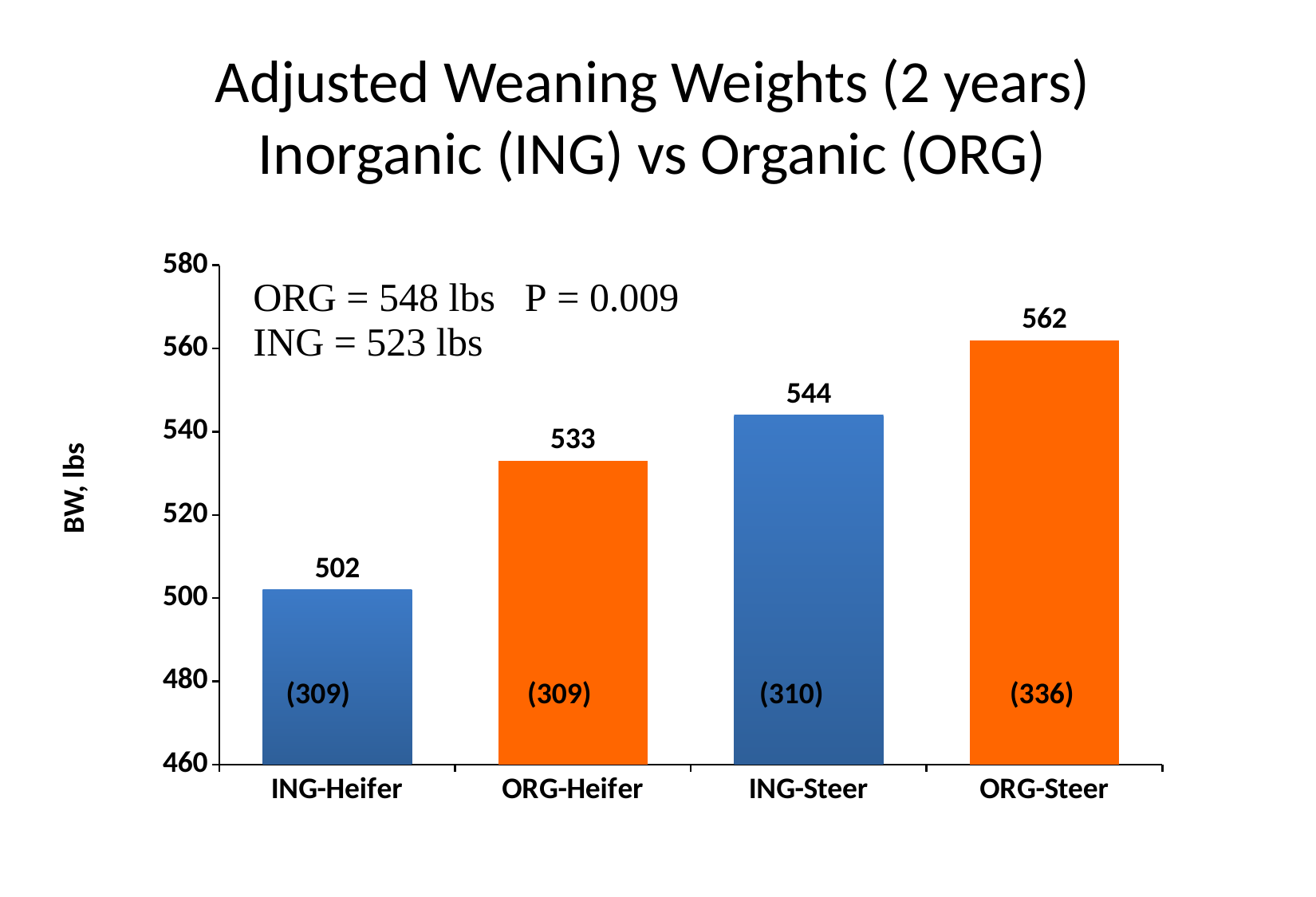
What is the value shown for ORG-Heifer? 533 What is the adjusted weaning weight for ORG-Steer? 562 Which category has the highest adjusted weaning weight? ORG-Steer What is the difference between the ORG-Heifer and ING-Heifer values? 31 What is the adjusted weaning weight for ING-Heifer? 502 Which category has the lowest adjusted weaning weight? ING-Heifer What kind of chart is shown on the slide? Bar chart Which is larger, the value for ING-Steer or ORG-Heifer? ING-Steer Is the value for ING-Steer greater or less than 540? greater What is the label on the y axis? BW, lbs How many categories are shown on the x axis? 4 What is the difference between the ORG-Steer and ING-Steer values? 18